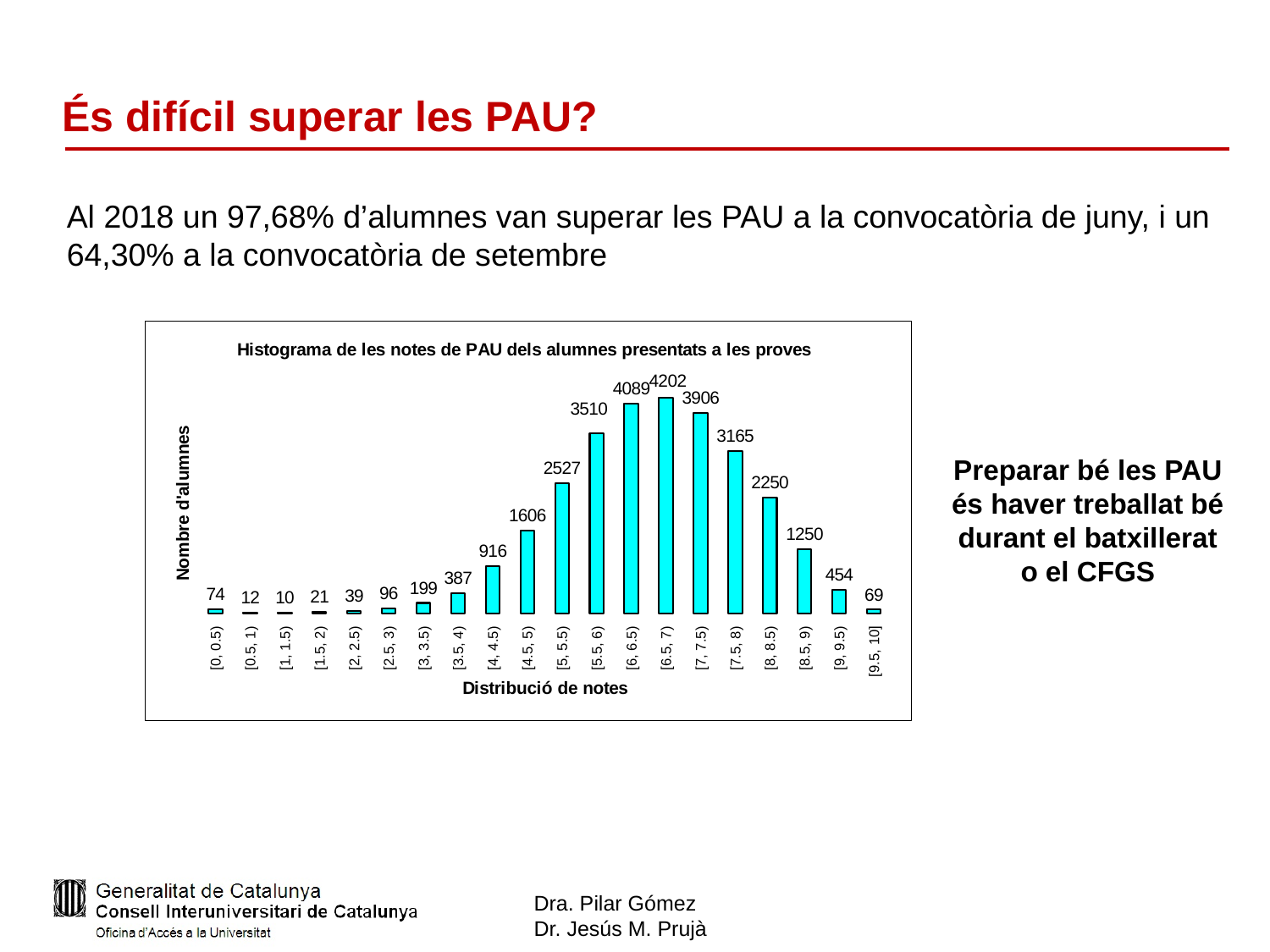
What is the number of students in the [6.5, 7) grade interval? 4202 Do the values rise or fall from the [6.5, 7) interval to the [9.5, 10] interval? Fall What is the number of students in the [9.5, 10] grade interval? 69 Which grade interval has the highest number of students? [6.5, 7) What type of chart is shown on the slide? Bar chart Which grade interval has the lowest number of students? [1, 1.5) What is the label of the y axis of the chart? Nombre d'alumnes How many grade intervals are shown on the x axis? 20 What is the number of students in the [4, 4.5) grade interval? 916 What is the title of the chart? Histograma de les notes de PAU dels alumnes presentats a les proves Which interval has more students, [7.5, 8) or [8, 8.5)? [7.5, 8) What is the difference in number of students between the [6, 6.5) and [5.5, 6) intervals? 579